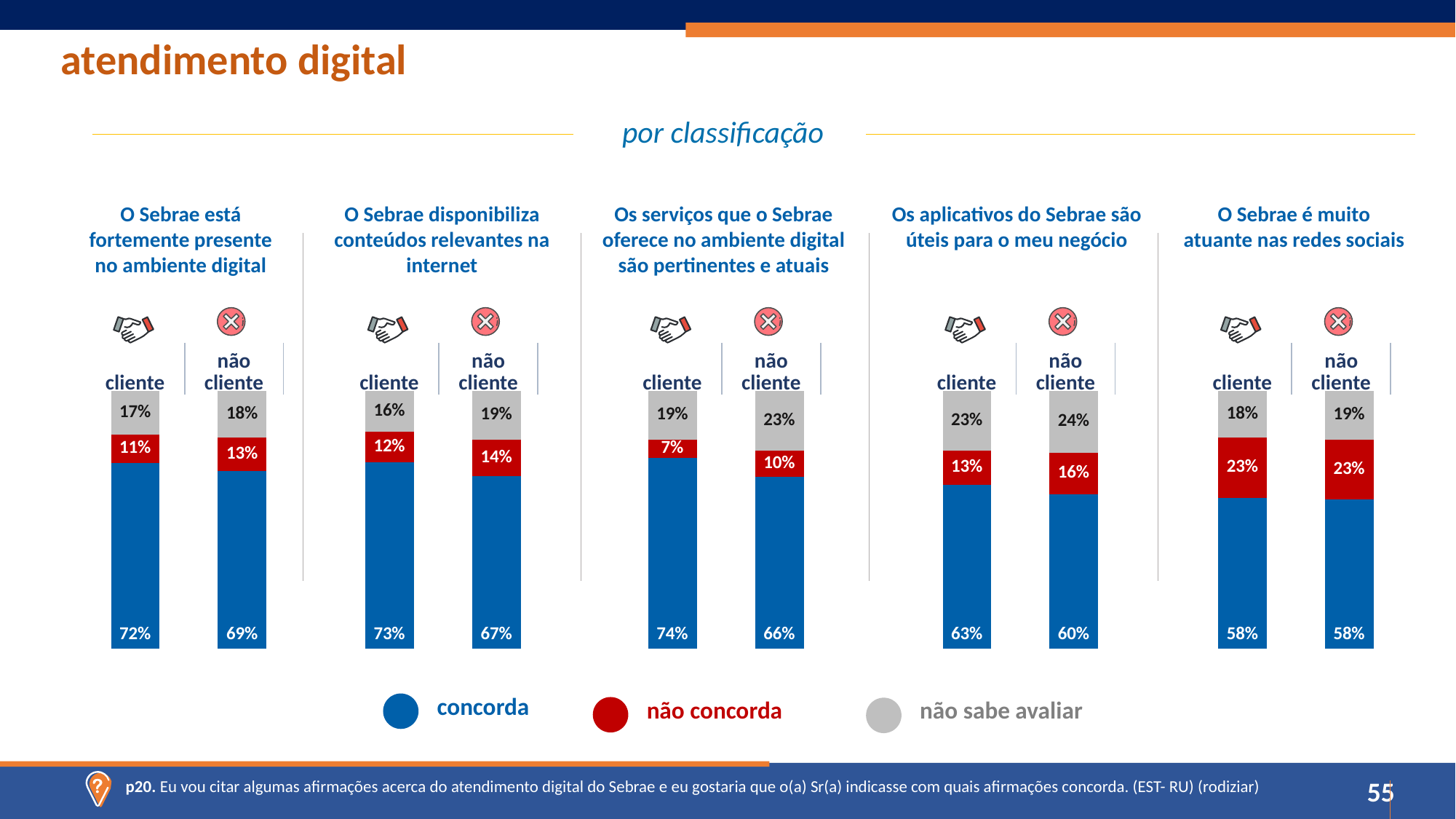
In the chart titled "O Sebrae disponibiliza conteúdos relevantes na internet", what is the "não concorda" value for não cliente? 14% In the chart titled "Os serviços que o Sebrae oferece no ambiente digital são pertinentes e atuais", what is the "não sabe avaliar" value for não cliente? 23% In the chart titled "O Sebrae disponibiliza conteúdos relevantes na internet", which group has the higher "concorda" value, cliente or não cliente? cliente In the chart titled "O Sebrae está fortemente presente no ambiente digital", what is the "concorda" value for cliente? 72% Across the five charts, which statement has the lowest "concorda" value for cliente? O Sebrae é muito atuante nas redes sociais In the chart titled "O Sebrae é muito atuante nas redes sociais", what is the "não concorda" value for cliente? 23% In the chart titled "Os aplicativos do Sebrae são úteis para o meu negócio", which group has the higher "não concorda" value, cliente or não cliente? não cliente How many series does the legend list? 3 In the chart titled "Os aplicativos do Sebrae são úteis para o meu negócio", what is the "concorda" value for não cliente? 60% In the chart titled "Os serviços que o Sebrae oferece no ambiente digital são pertinentes e atuais", what is the difference between the "concorda" values for cliente and não cliente? 8 percentage points What type of chart is used on this slide? Stacked bar chart Across the five charts, which statement has the highest "concorda" value for cliente? Os serviços que o Sebrae oferece no ambiente digital são pertinentes e atuais